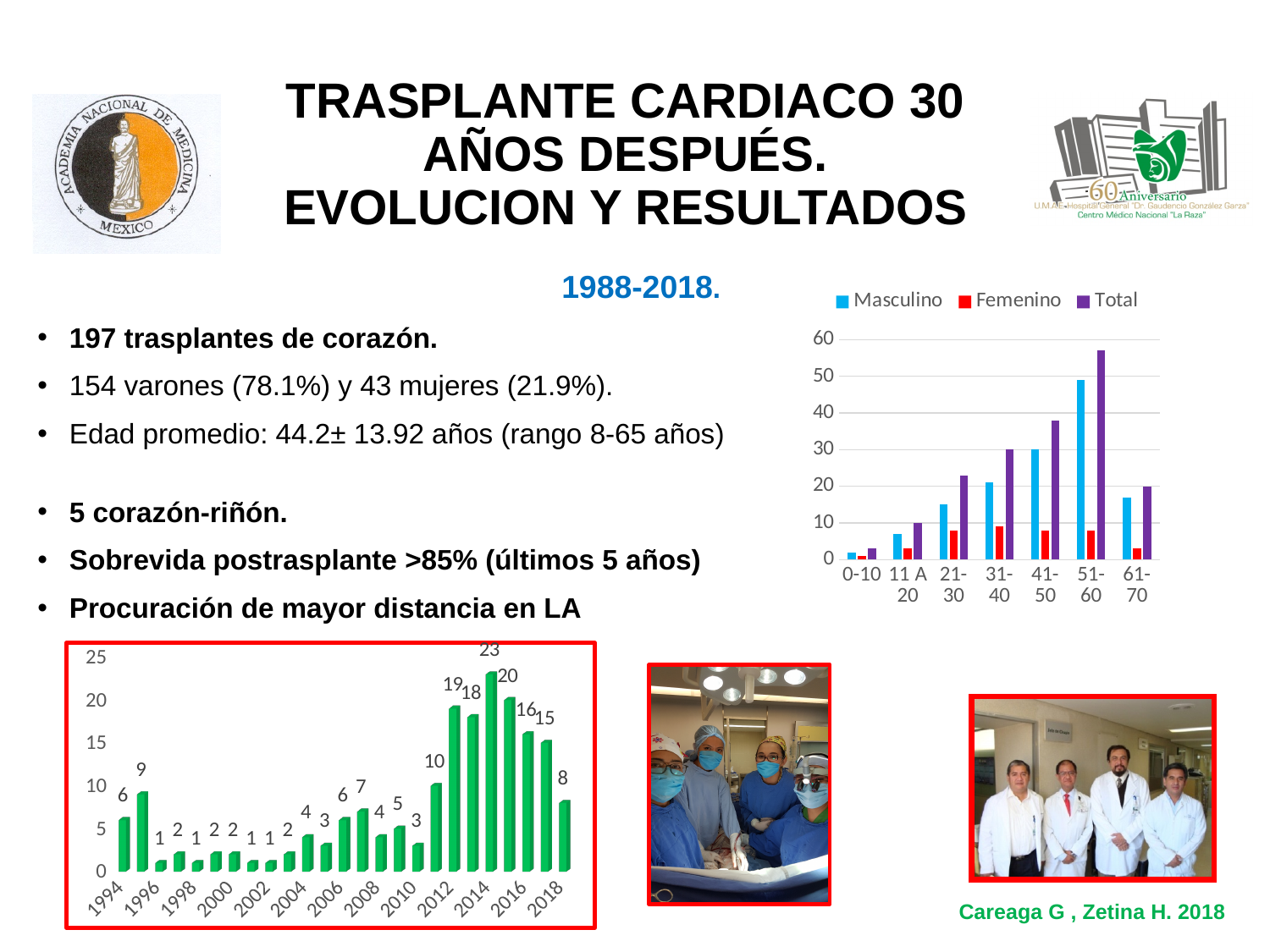
In the bottom-left chart, what is the value for 1994? 6 In the top-right chart, which age group has the highest Total value? 51-60 In the bottom-left chart, what is the difference between the values for 2014 and 2016? 7 In the top-right chart, how many series does the legend list? 3 In the bottom-left chart, what is the value for 2012? 19 In the bottom-left chart, which year has the highest value? 2014 What kind of chart is the bottom-left chart? bar chart In the bottom-left chart, which is larger, the value for 2012 or the value for 2018? 2012 In the bottom-left chart, what is the value for 2018? 8 In the top-right chart, is the Total value for 51-60 greater or less than 50? greater In the bottom-left chart, how many bars are plotted? 25 In the bottom-left chart, what is the value for 2014? 23